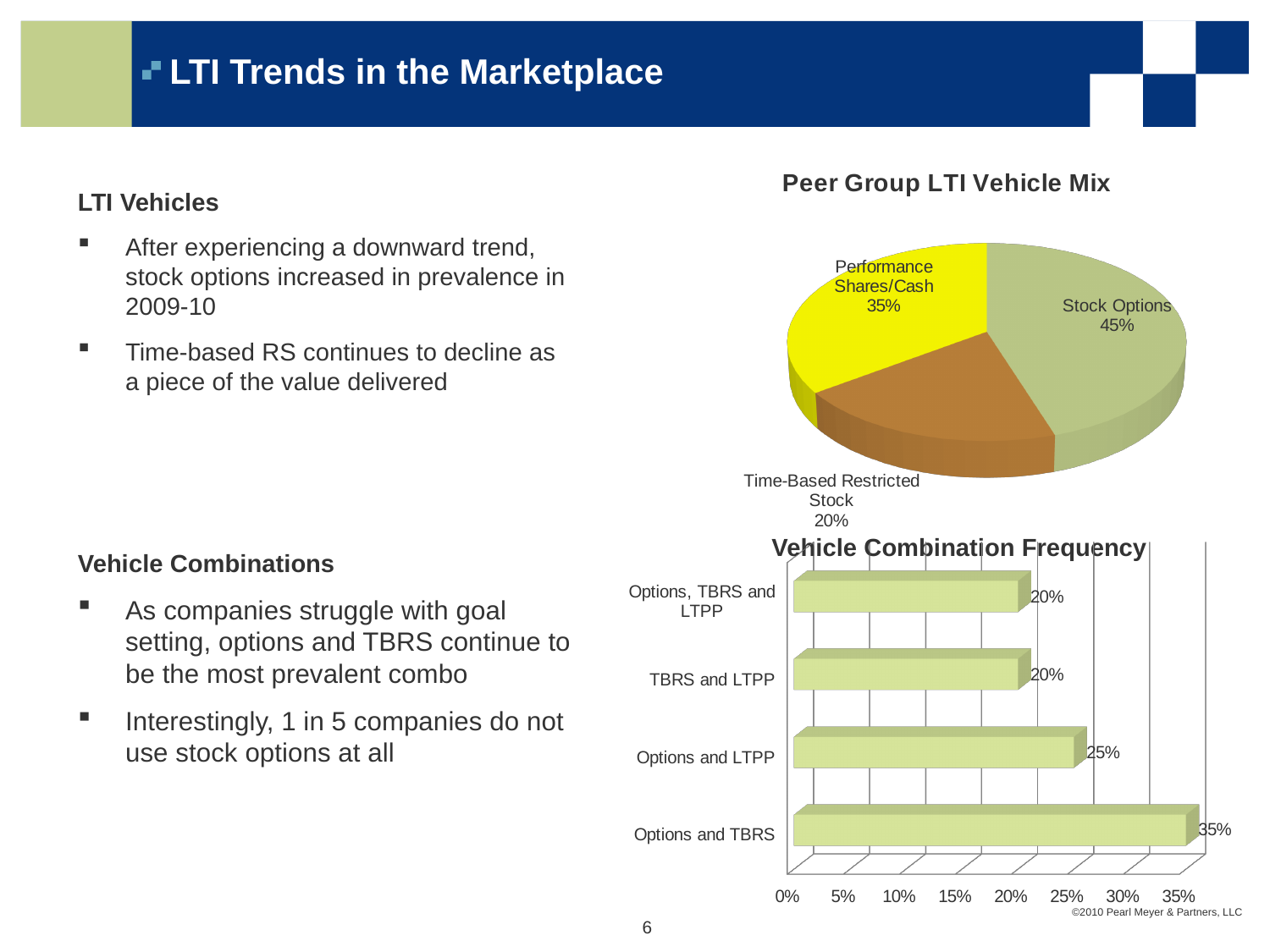
In the Peer Group LTI Vehicle Mix chart, what share does Stock Options have? 45% In the Vehicle Combination Frequency chart, what is the difference between Options and TBRS and TBRS and LTPP? 15% In the Peer Group LTI Vehicle Mix chart, what share does Time-Based Restricted Stock have? 20% In the Vehicle Combination Frequency chart, which category has the highest value? Options and TBRS In the Vehicle Combination Frequency chart, how many categories are shown? 4 In the Vehicle Combination Frequency chart, what is the value for Options and LTPP? 25% What kind of chart is the Peer Group LTI Vehicle Mix chart? Pie chart In the Peer Group LTI Vehicle Mix chart, which slice is the smallest? Time-Based Restricted Stock In the Peer Group LTI Vehicle Mix chart, what is the difference between the Stock Options share and the Performance Shares/Cash share? 10% What kind of chart is the Vehicle Combination Frequency chart? Bar chart In the Peer Group LTI Vehicle Mix chart, which slice is the largest? Stock Options In the Peer Group LTI Vehicle Mix chart, how many slices does the pie have? 3